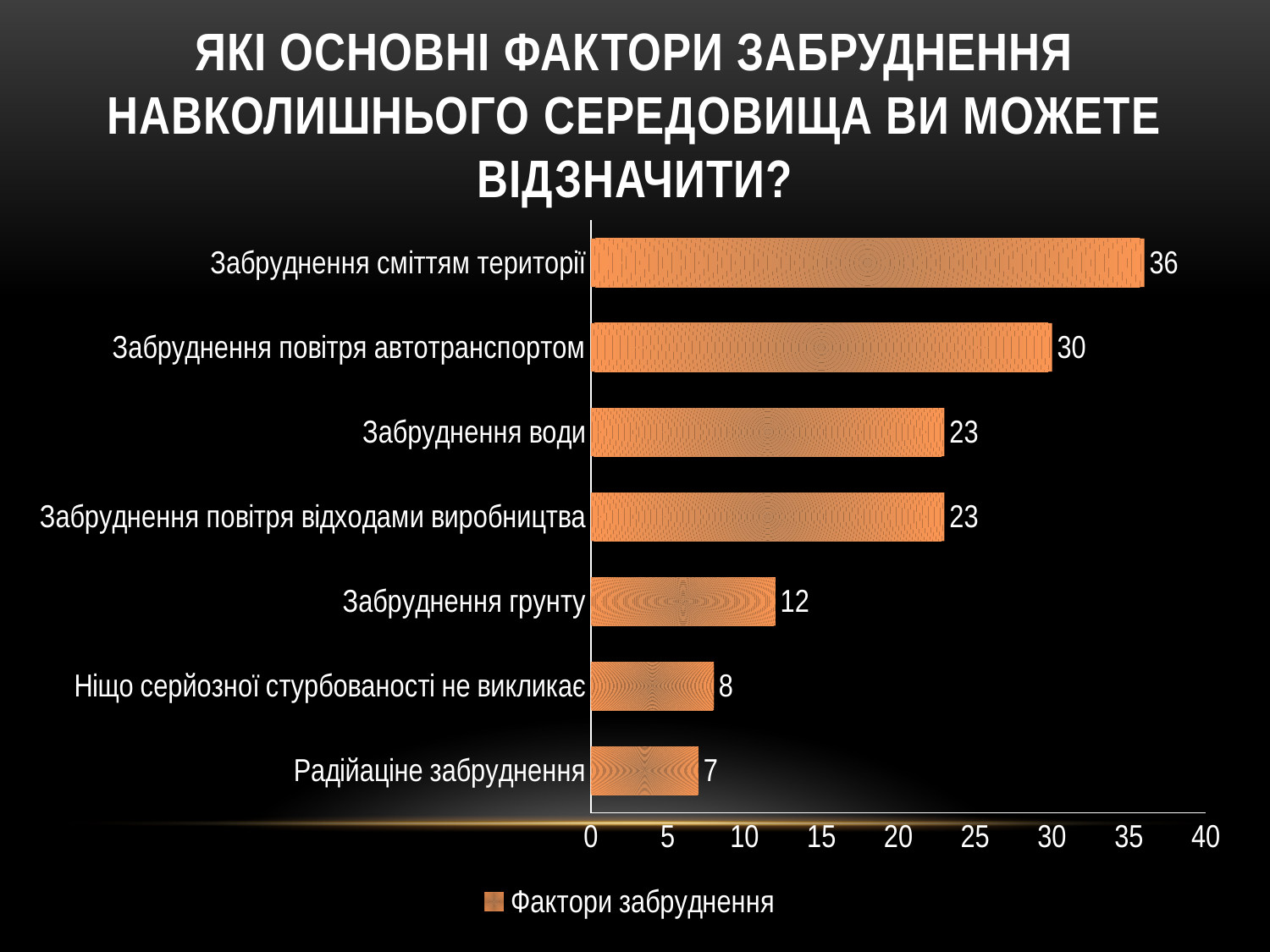
What is the legend entry shown below the chart? Фактори забруднення What is the difference between the values for Забруднення сміттям території and Забруднення повітря автотранспортом? 6 How many categories are shown in the chart? 7 What kind of chart is shown on the slide? bar chart Is the value for Ніщо серйозної стурбованості не викликає greater or less than 10? less What is the value for Забруднення грунту? 12 Which is larger, the value for Забруднення води or the value for Забруднення грунту? Забруднення води Which category has the lowest value? Радійаціне забруднення What is the value for Радійаціне забруднення? 7 What is the value for Забруднення сміттям території? 36 What is the value for Забруднення повітря автотранспортом? 30 Which category has the highest value? Забруднення сміттям території